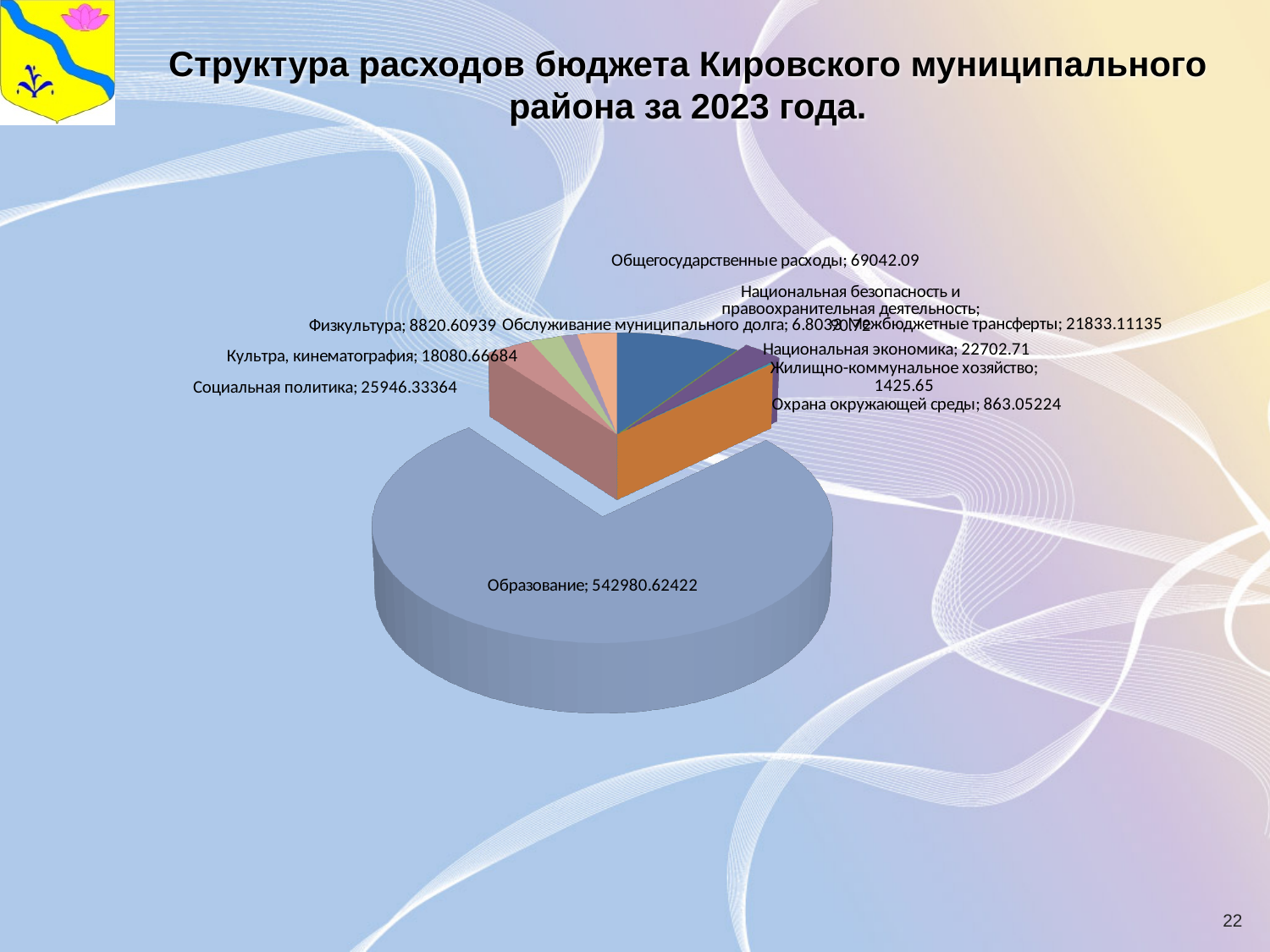
What is the value shown for Социальная политика? 25946.33364 What is the value shown for Образование? 542980.62422 Which is larger, Физкультура or Культра, кинематография? Культра, кинематография Which category has the largest slice of the pie? Образование What is the value shown for Общегосударственные расходы? 69042.09 What is the value shown for Жилищно-коммунальное хозяйство? 1425.65 What kind of chart is shown on the slide? pie chart Which is larger, Межбюджетные трансферты or Национальная экономика? Национальная экономика What is the difference between the values for Социальная политика and Культра, кинематография? 7865.6668 What is the value shown for Охрана окружающей среды? 863.05224 What is the value shown for Национальная экономика? 22702.71 What is the title of the slide? Структура расходов бюджета Кировского муниципального района за 2023 года.